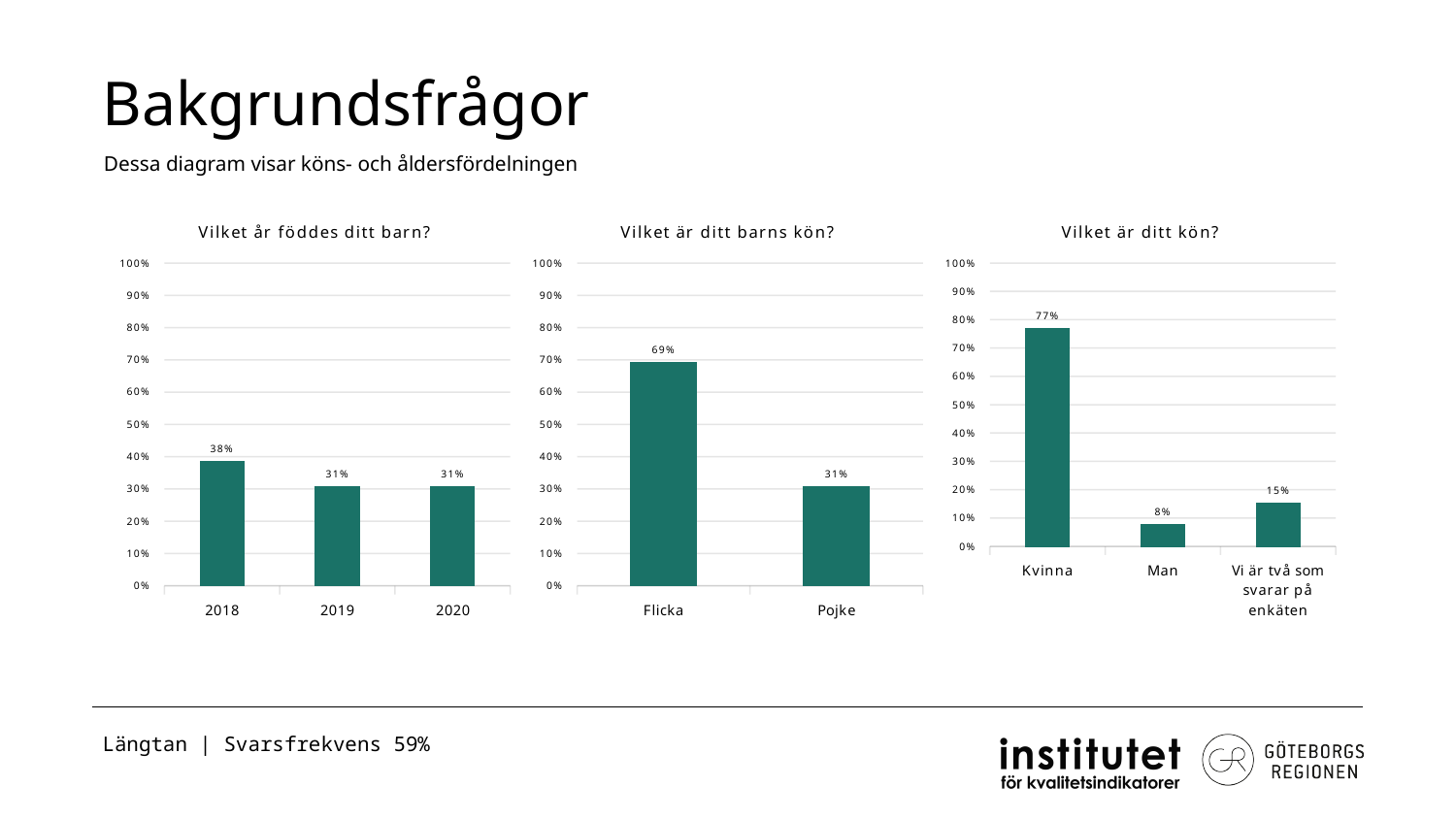
What kind of chart is 'Vilket är ditt kön?'? Bar chart How many charts are shown on the slide? 3 In the chart 'Vilket år föddes ditt barn?', how many categories are shown on the x axis? 3 In the chart 'Vilket är ditt kön?', which category has the lowest value? Man In the chart 'Vilket är ditt kön?', what is the value for Man? 8% In the chart 'Vilket är ditt kön?', what is the difference between Kvinna and Man? 69% In the chart 'Vilket är ditt barns kön?', what is the value for Flicka? 69% In the chart 'Vilket är ditt barns kön?', is the value for Pojke greater or less than 40%? less In the chart 'Vilket år föddes ditt barn?', what is the value for 2018? 38% In the chart 'Vilket är ditt barns kön?', what is the difference between Flicka and Pojke? 38% In the chart 'Vilket år föddes ditt barn?', which year has the highest value? 2018 In the chart 'Vilket är ditt kön?', which is larger, Man or 'Vi är två som svarar på enkäten'? Vi är två som svarar på enkäten